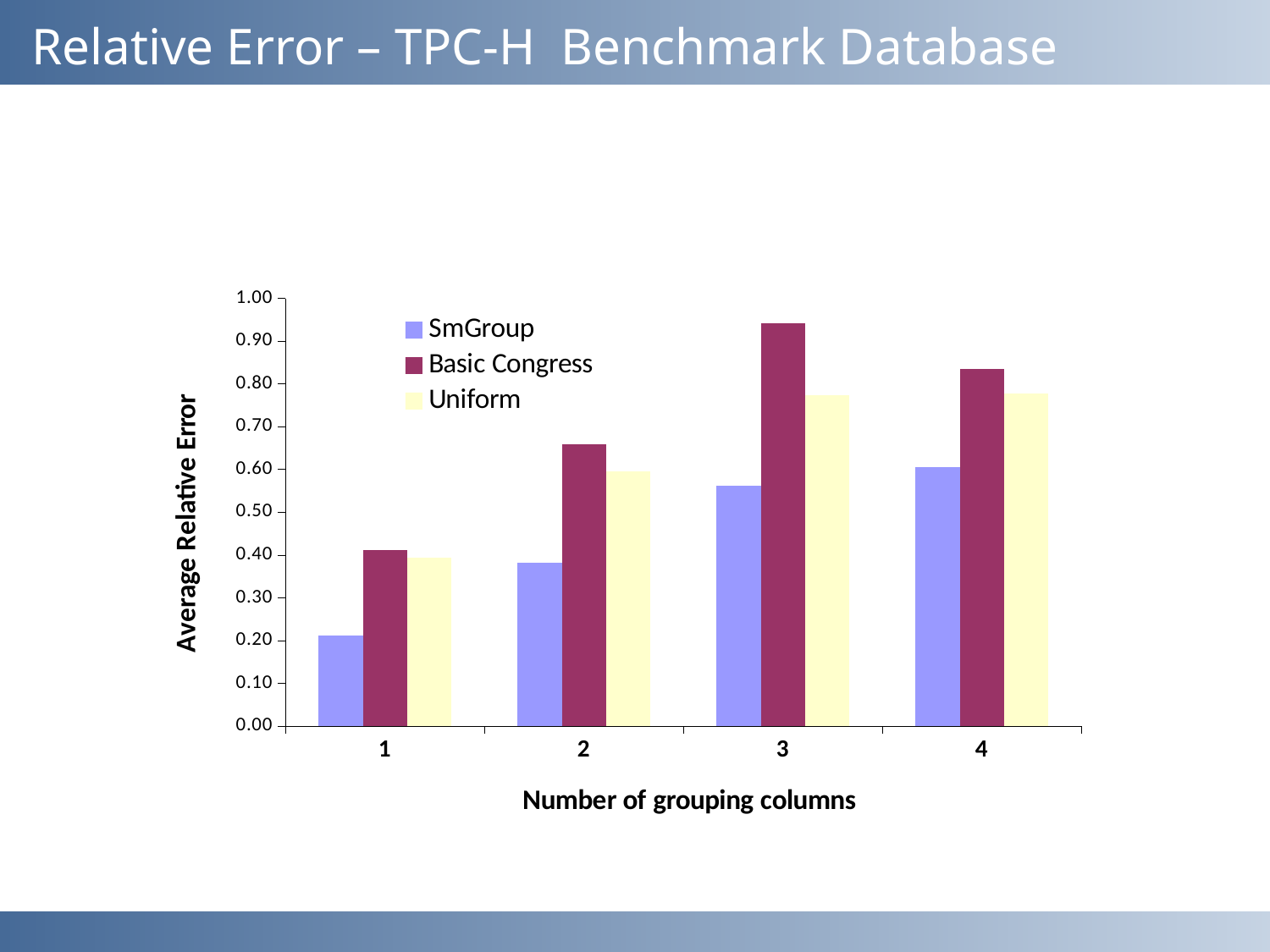
What kind of chart is shown on the slide? bar chart For the Basic Congress series, at which number of grouping columns is the average relative error highest? 3 Is the value for SmGroup at 1 grouping column greater or less than 0.30? less Which series has the highest average relative error at 3 grouping columns? Basic Congress What is the title of the y axis? Average Relative Error How many categories (numbers of grouping columns) are shown on the x axis? 4 Does the SmGroup series rise or fall as the number of grouping columns increases from 1 to 4? rise At 2 grouping columns, which is larger: Basic Congress or Uniform? Basic Congress How many series does the legend list? 3 Is the value for Uniform at 4 grouping columns greater or less than 0.70? greater Which series has the lowest average relative error at 1 grouping column? SmGroup Is the value for Basic Congress at 3 grouping columns greater or less than 0.90? greater